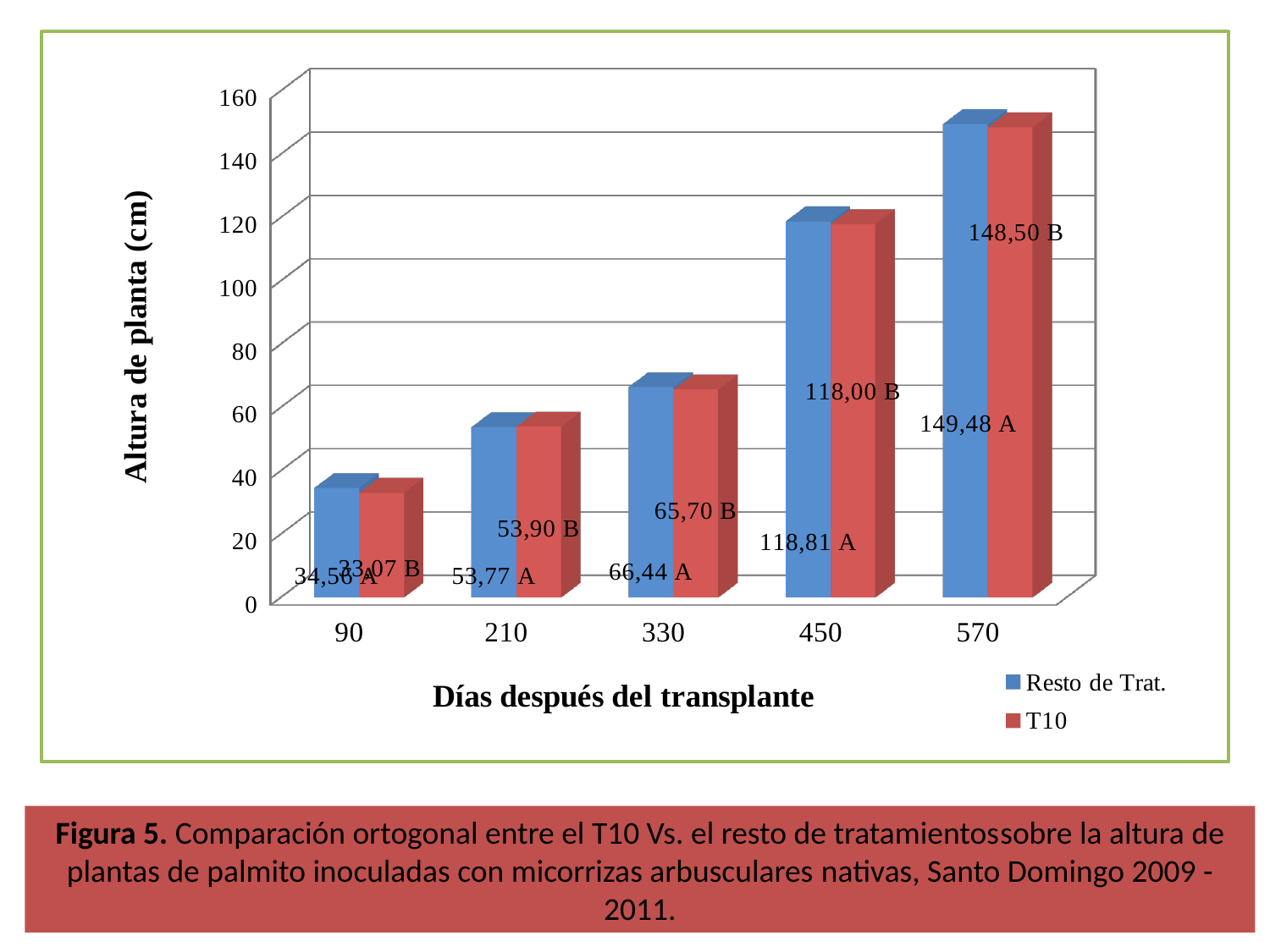
At which number of days after transplant is the Resto de Trat. plant height highest? 570 Is the T10 plant height at 330 days greater or less than 80? less How many categories (days after transplant) are shown on the x axis? 5 What is the plant height for Resto de Trat. at 450 days after transplant? 118,81 A What is the plant height for T10 at 210 days after transplant? 53,90 B Do the plant heights rise or fall as the days after transplant increase? rise At which number of days after transplant is the T10 plant height lowest? 90 What type of chart is shown on the slide? bar chart How many series does the legend list? 2 What is the difference between the Resto de Trat. height at 570 days and at 450 days? 30,67 What is the plant height for T10 at 570 days after transplant? 148,50 B What is the plant height for Resto de Trat. at 330 days after transplant? 66,44 A